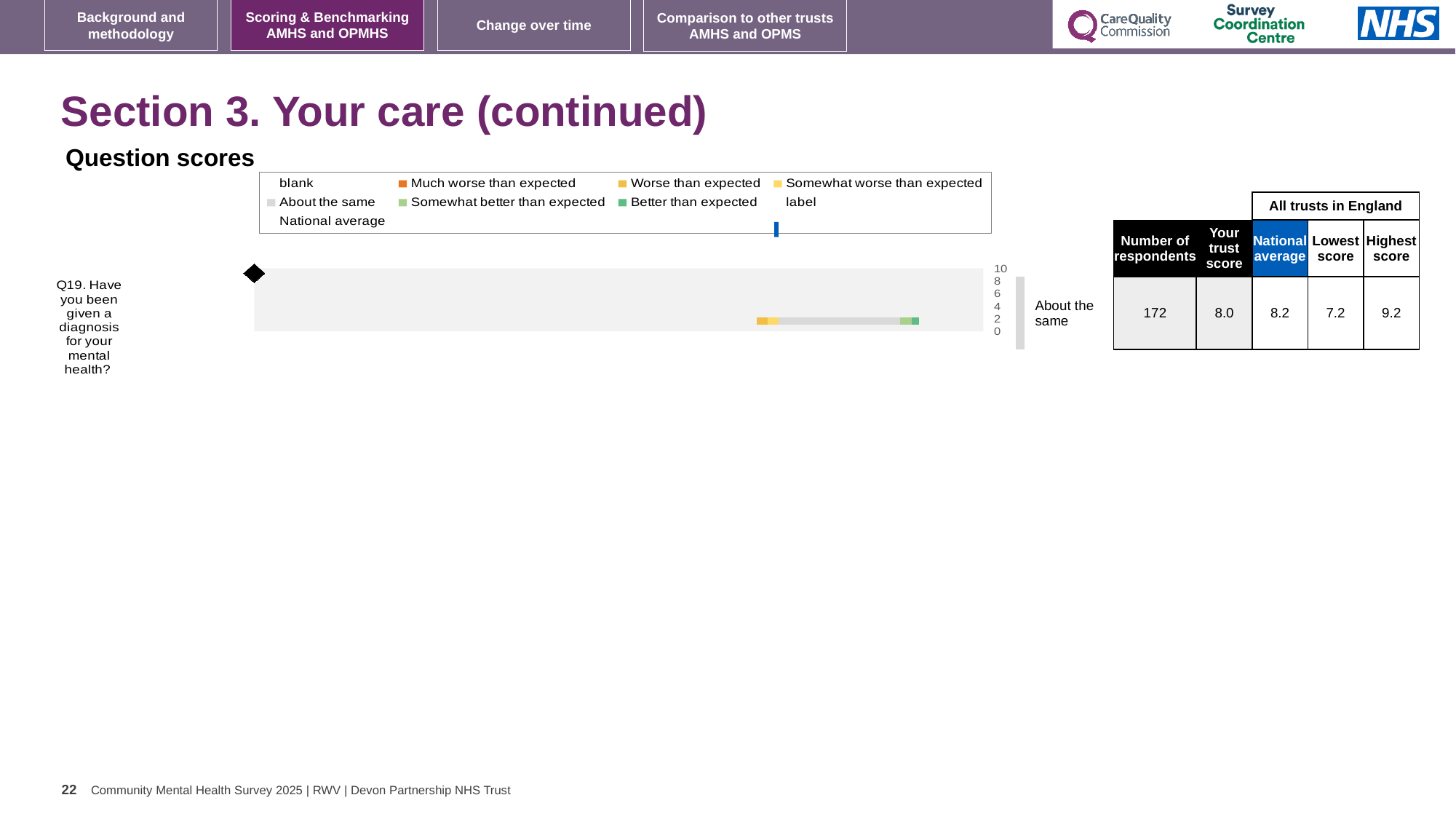
How many respondents are shown for Q19? 172 What benchmark category label is shown next to the bar for Q19? About the same Which is larger for Q19: the trust score or the national average? National average What is the difference between the highest score and the lowest score shown for Q19? 2.0 How many questions are plotted in the chart? 1 What is the lowest score among all trusts in England shown for Q19? 7.2 What is the 'Your trust score' shown for Q19 (Have you been given a diagnosis for your mental health?)? 8.0 What is the highest score among all trusts in England shown for Q19? 9.2 What is the title of the chart? Question scores What kind of chart is used to show the question scores? Bar chart By how much does the national average exceed the trust score for Q19? 0.2 What is the national average score shown for Q19? 8.2